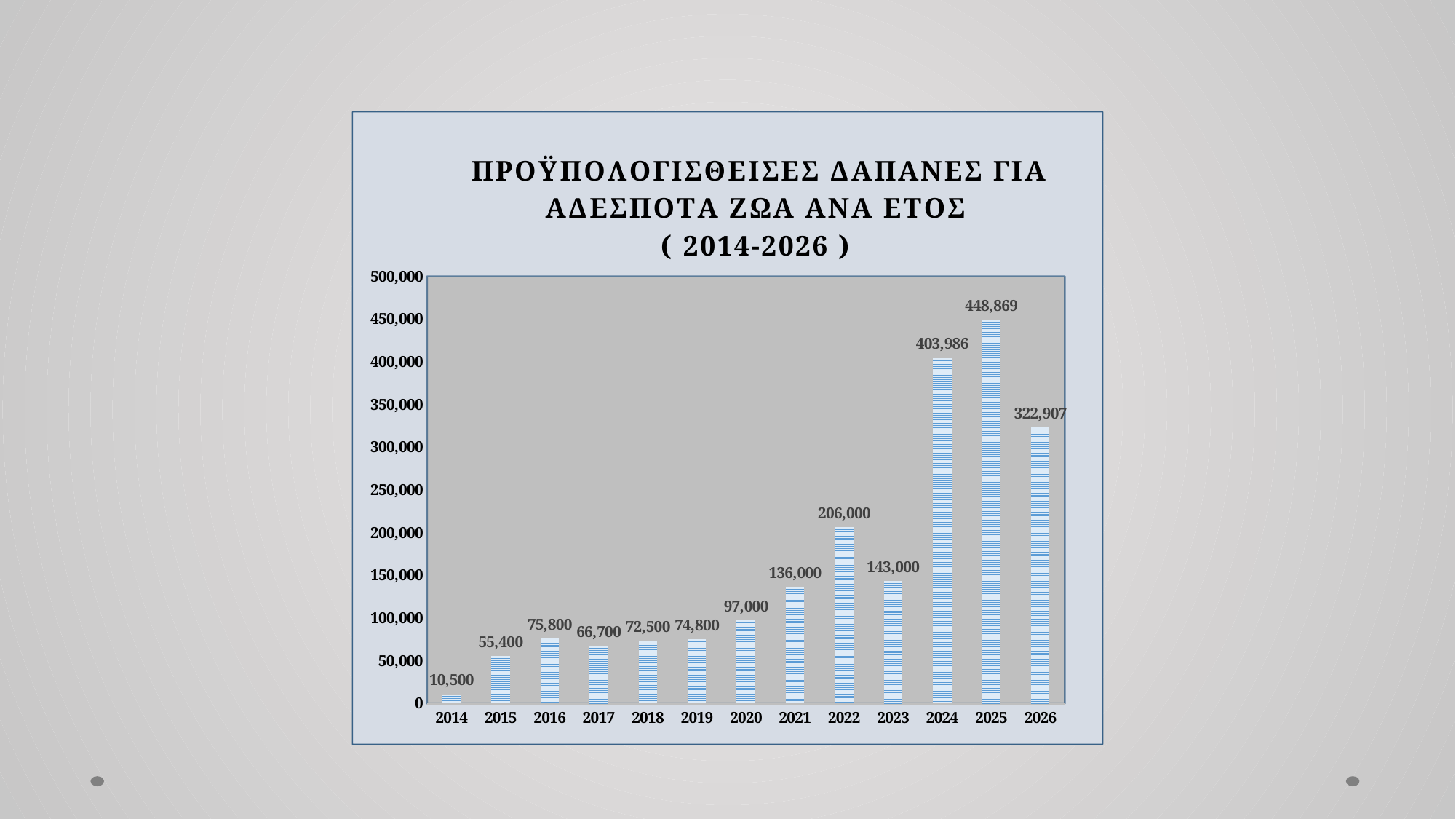
Is the value for 2024 greater or less than 400,000? greater Which year has the highest value? 2025 Which is larger, the value for 2016 or the value for 2017? 2016 What kind of chart is this? bar chart How many years are shown on the x axis? 13 Which year has the lowest value? 2014 What is the value for 2022? 206,000 What is the value for 2026? 322,907 What is the value for 2014? 10,500 What is the difference between the values for 2023 and 2021? 7,000 Do the values rise or fall from 2019 to 2022? rise What is the difference between the values for 2025 and 2024? 44,883